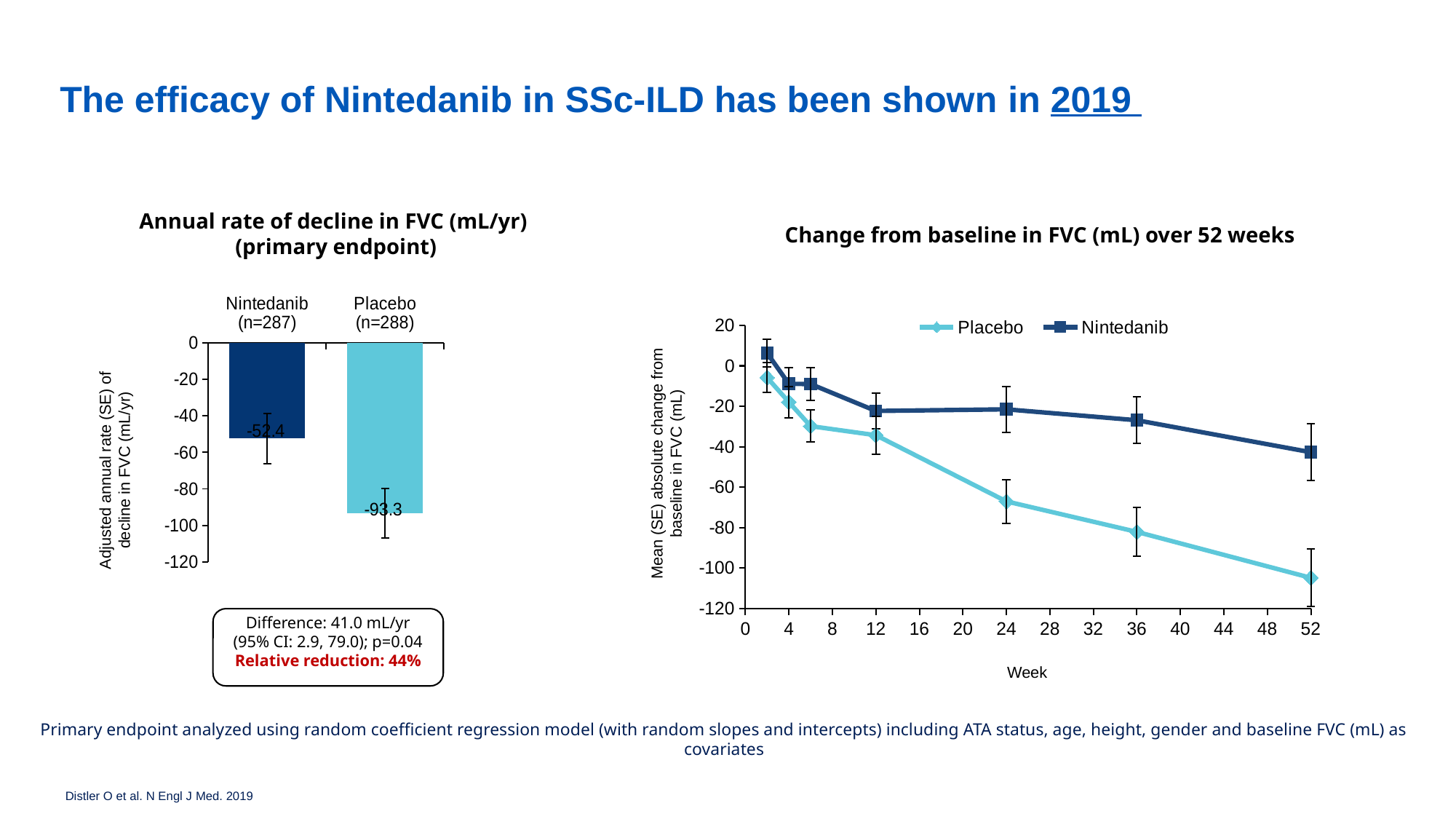
In the 'Annual rate of decline in FVC' chart, which group has the larger decline (more negative value)? Placebo What kind of chart is the 'Change from baseline in FVC (mL) over 52 weeks' chart? line chart In the 'Annual rate of decline in FVC' chart, what is the value for Nintedanib? -52.4 How many series does the legend of the 'Change from baseline in FVC (mL) over 52 weeks' chart list? 2 In the 'Change from baseline in FVC (mL) over 52 weeks' chart, which series has the higher value at week 52? Nintedanib What kind of chart is the 'Annual rate of decline in FVC' chart? bar chart In the 'Change from baseline in FVC (mL) over 52 weeks' chart, is the Placebo value at week 52 greater or less than -80? less In the 'Annual rate of decline in FVC' chart, what is the value for Placebo? -93.3 In the 'Change from baseline in FVC (mL) over 52 weeks' chart, does the Placebo line rise or fall as the weeks increase? fall In the 'Annual rate of decline in FVC' chart, what relative reduction is stated in the box below the bars? 44% In the 'Change from baseline in FVC (mL) over 52 weeks' chart, is the Nintedanib value at week 52 greater or less than -60? greater How many bars are shown in the 'Annual rate of decline in FVC' chart? 2